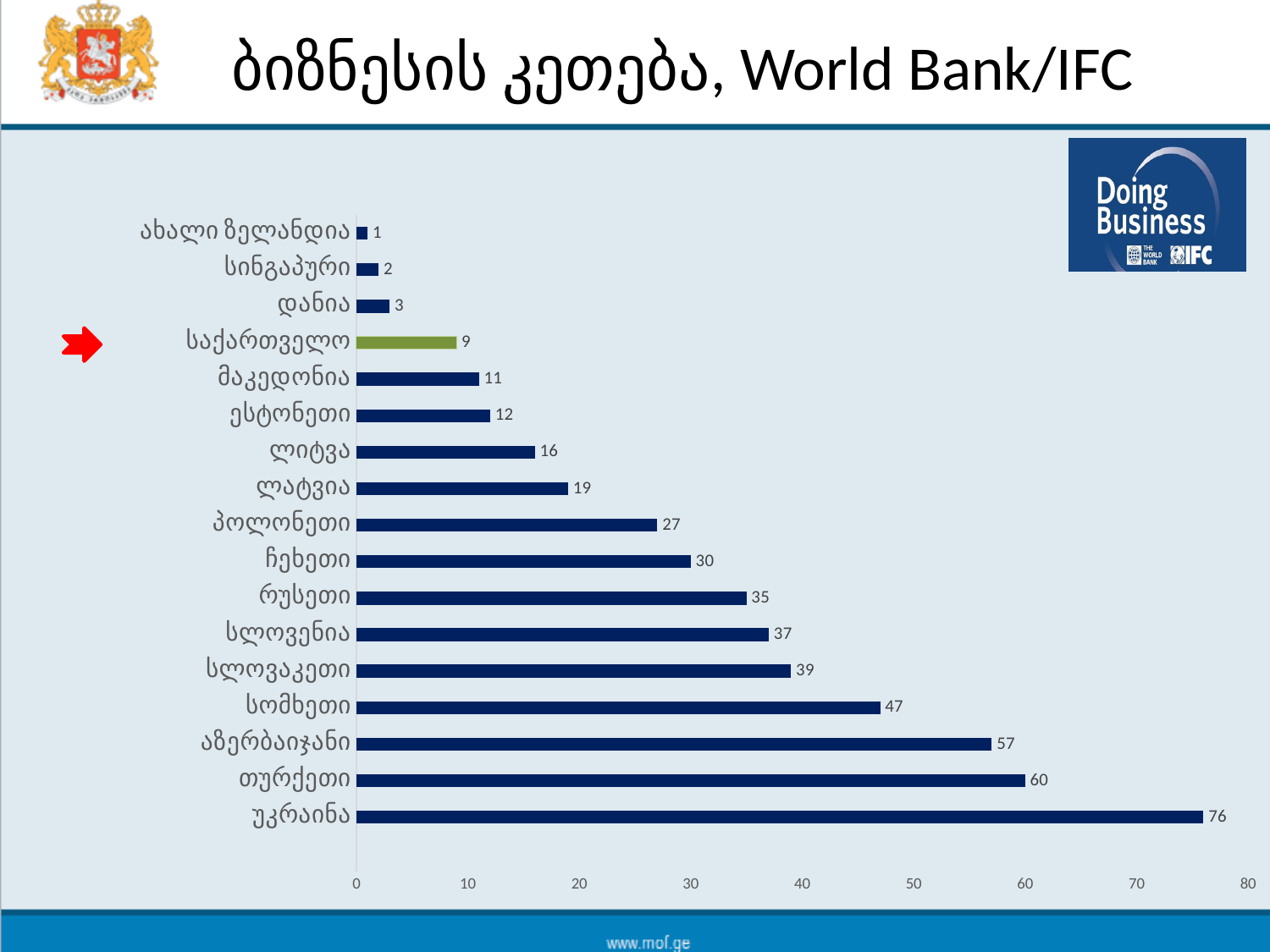
Which bar is highlighted in a different colour (green) from the others? საქართველო What is the value for ესტონეთი? 12 Which has a larger value, რუსეთი or პოლონეთი? რუსეთი How many categories are shown in the chart? 17 Which category has the highest value? უკრაინა What is the difference between the values for უკრაინა and საქართველო? 67 What is the value for სომხეთი? 47 What is the value for საქართველო? 9 Which category has the lowest value? ახალი ზელანდია What is the difference between the values for თურქეთი and აზერბაიჯანი? 3 What kind of chart is shown on the slide? Bar chart What is the value for უკრაინა? 76